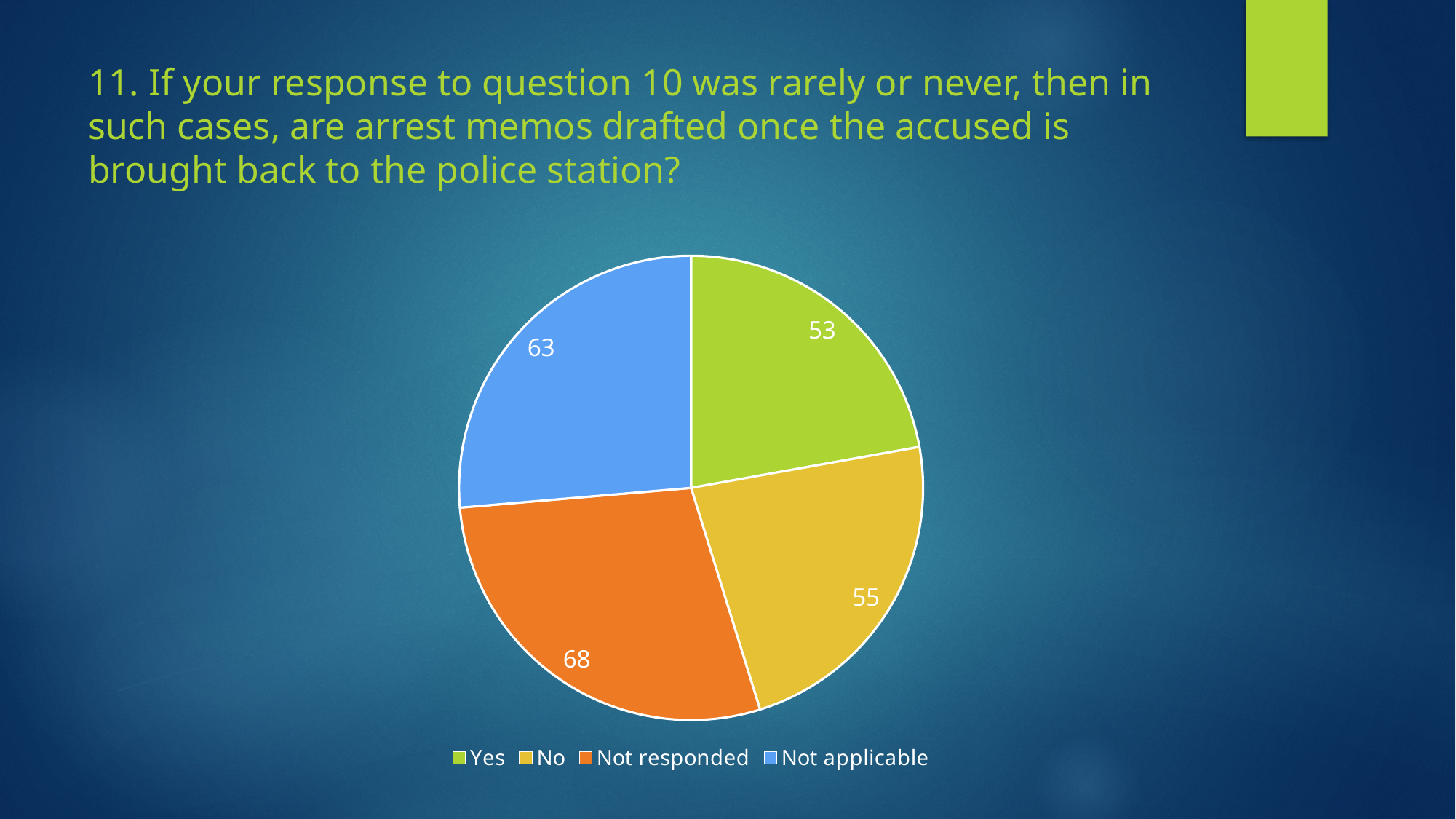
What is the value for the "No" slice? 55 How many slices does the pie chart have? 4 What is the value for the "Yes" slice? 53 What is the total of all four slices? 239 What is the value for the "Not applicable" slice? 63 Which category is shown in orange in the legend? Not responded Which category has the largest slice? Not responded What kind of chart is shown on the slide? pie chart What is the value for the "Not responded" slice? 68 Which is larger, the value for "Not applicable" or the value for "No"? Not applicable Which category has the smallest slice? Yes What is the difference between the "Not responded" and "Yes" values? 15